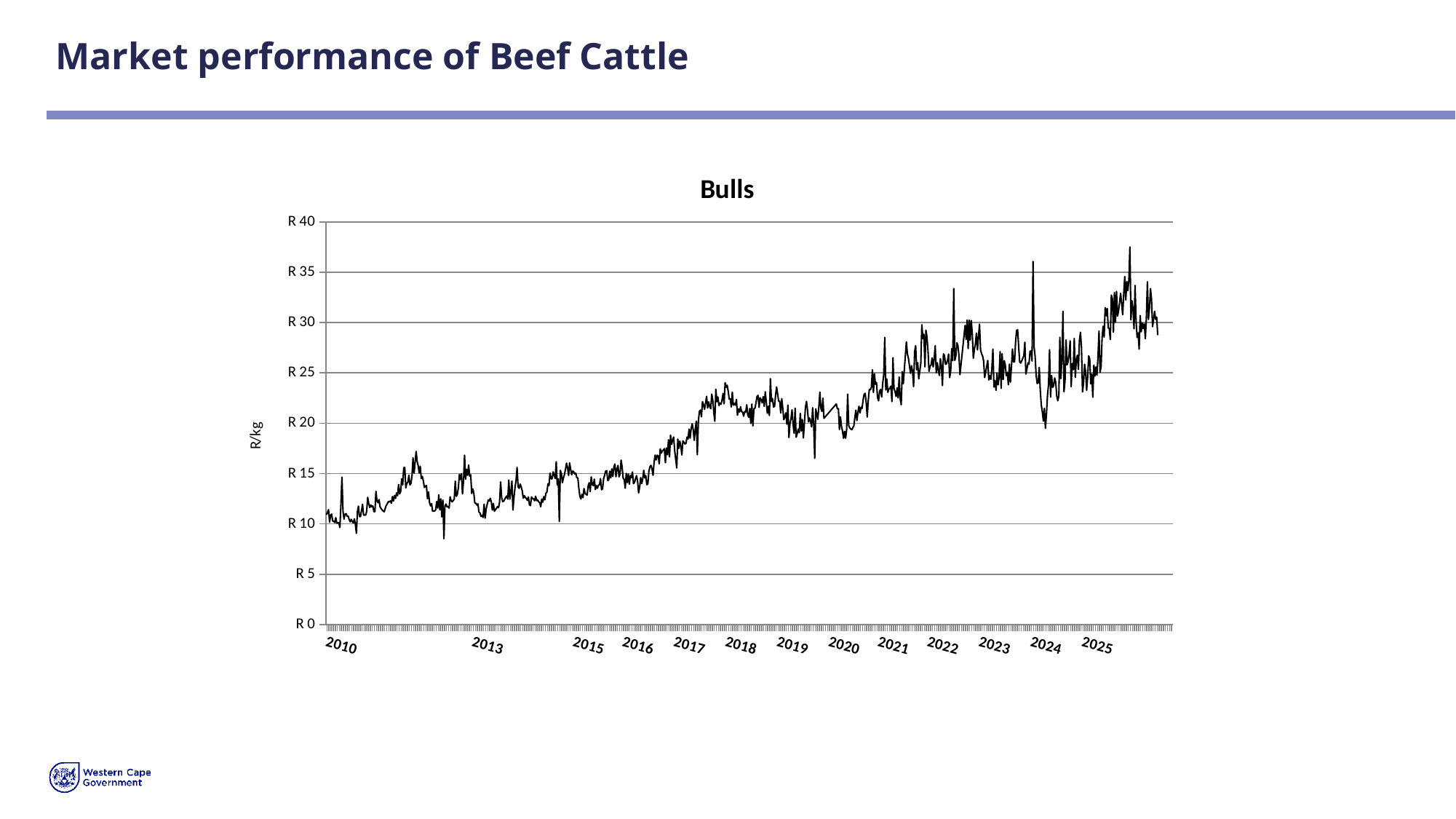
What is the title of the chart? Bulls Is the value for Bulls in 2017 greater or less than R 15? greater Is the value for Bulls at the start of 2010 greater or less than R 5? greater Overall, do the values in the Bulls chart rise or fall from 2010 to 2025? rise What is the highest value shown on the vertical axis of the chart? R 40 Is the value for Bulls in 2013 greater or less than R 20? less What kind of chart is shown on the slide? line chart What is the label on the vertical axis of the chart? R/kg How many year labels are shown along the horizontal axis of the chart? 13